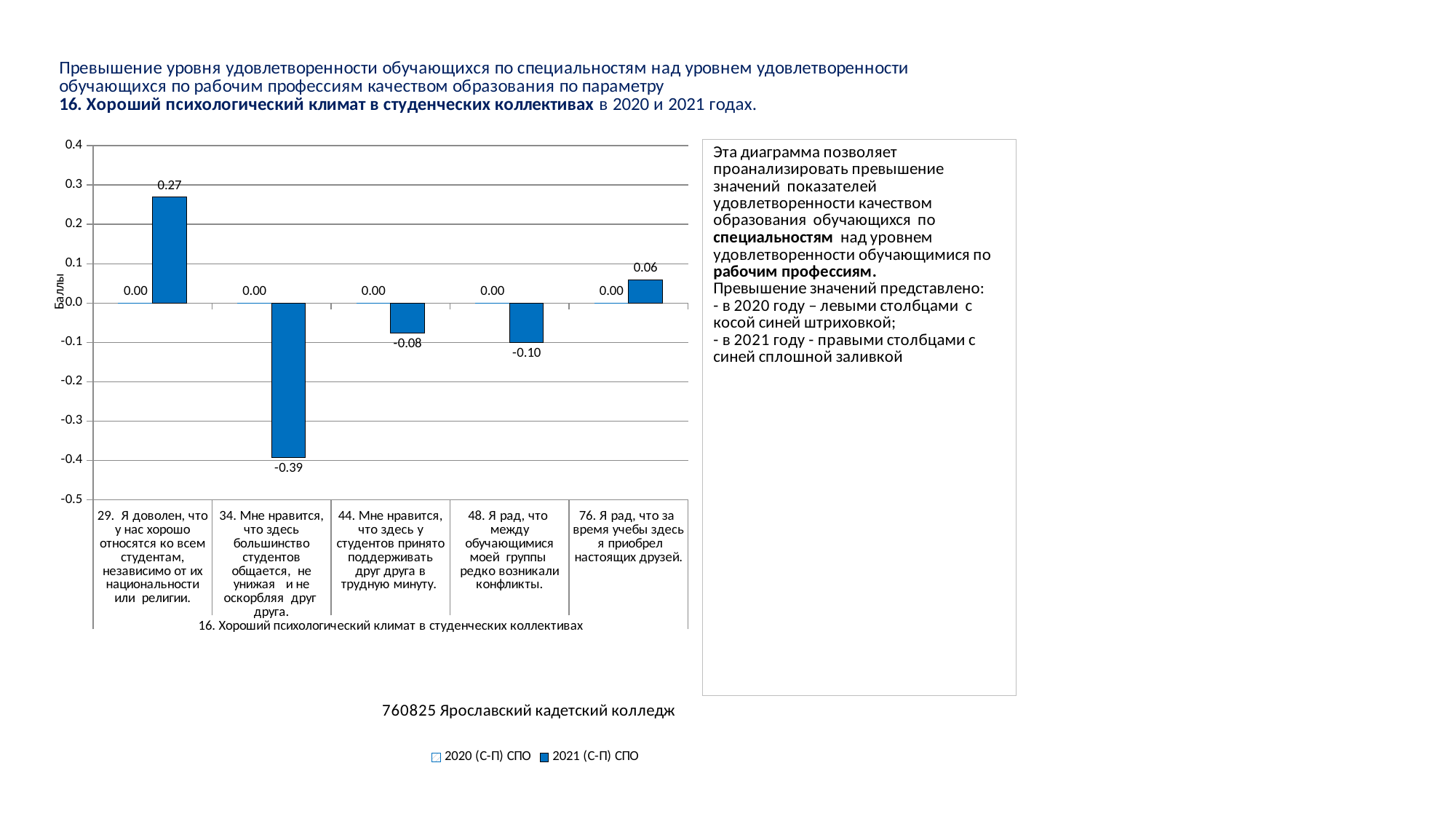
What is the label of the vertical axis of the chart? Баллы How many series does the chart legend list? 2 What is the 2021 (С-П) СПО value for category 76 ("Я рад, что за время учебы здесь я приобрел настоящих друзей")? 0.06 What type of chart is shown on the slide? Bar chart What is the 2020 (С-П) СПО value for category 44 ("Мне нравится, что здесь у студентов принято поддерживать друг друга в трудную минуту")? 0.00 Which is larger for 2021 (С-П) СПО: the value for category 44 or the value for category 48? Category 44 (-0.08) What is the difference between the 2021 (С-П) СПО values for category 29 and category 76? 0.21 Which category has the highest 2021 (С-П) СПО value? 29. Я доволен, что у нас хорошо относятся ко всем студентам, независимо от их национальности или религии. What is the 2021 (С-П) СПО value for category 34 ("Мне нравится, что здесь большинство студентов общается, не унижая и не оскорбляя друг друга")? -0.39 What is the 2021 (С-П) СПО value for category 29 ("Я доволен, что у нас хорошо относятся ко всем студентам...")? 0.27 How many categories are shown on the x axis of the chart? 5 Which category has the lowest 2021 (С-П) СПО value? 34. Мне нравится, что здесь большинство студентов общается, не унижая и не оскорбляя друг друга.